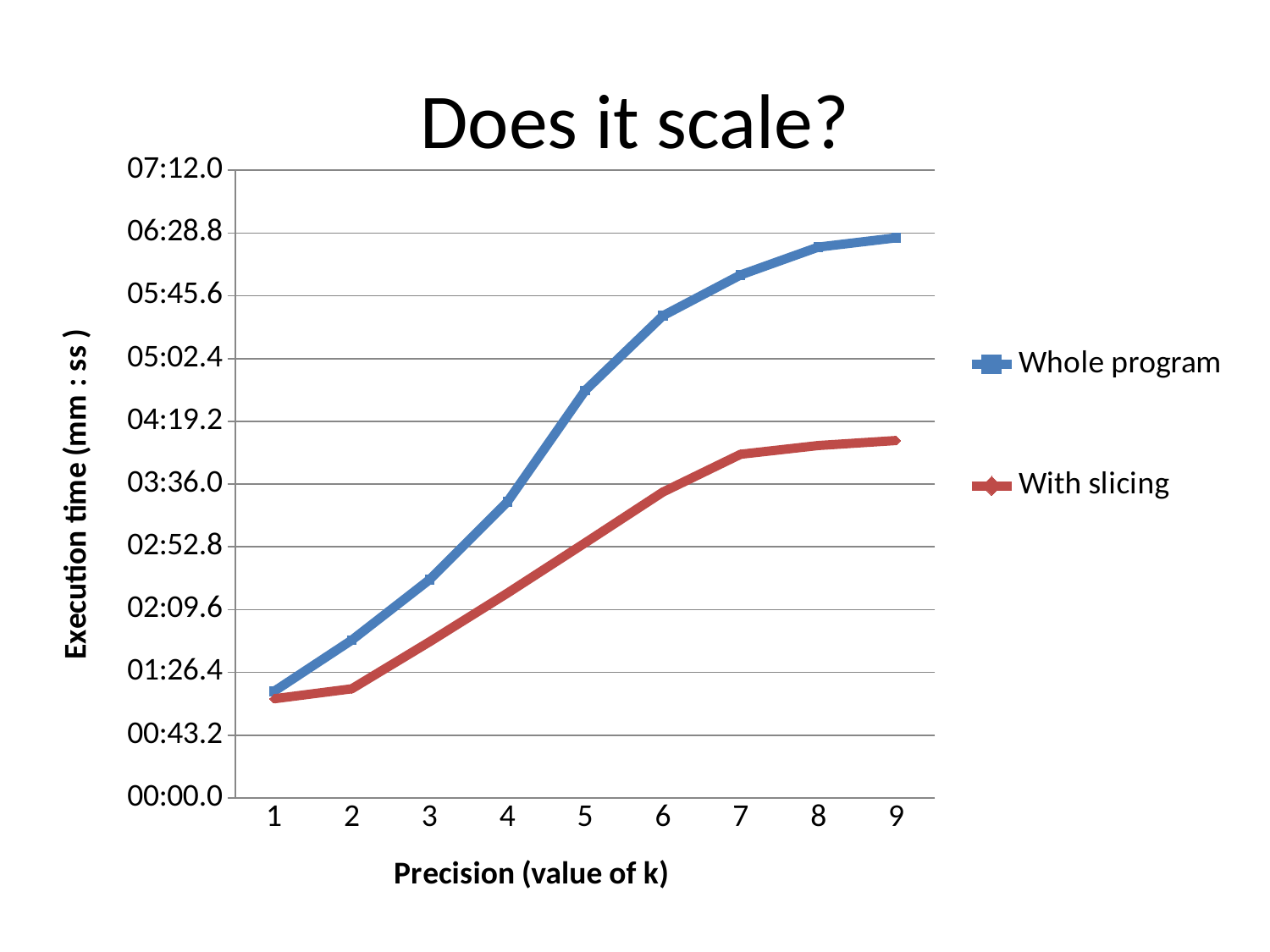
At which value of k is the With slicing execution time lowest? 1 How many series does the legend list? 2 At k = 5, which series has the higher execution time, Whole program or With slicing? Whole program Is the With slicing execution time at k = 5 greater or less than 03:36.0? less At which value of k is the Whole program execution time highest? 9 Does the execution time for Whole program rise or fall as k increases from 1 to 9? Rise What is the title of the chart? Does it scale? What kind of chart is shown on the slide? Line chart Is the With slicing execution time at k = 9 greater or less than 04:19.2? less Is the Whole program execution time at k = 1 greater or less than 01:26.4? less How many values of k are plotted along the x axis? 9